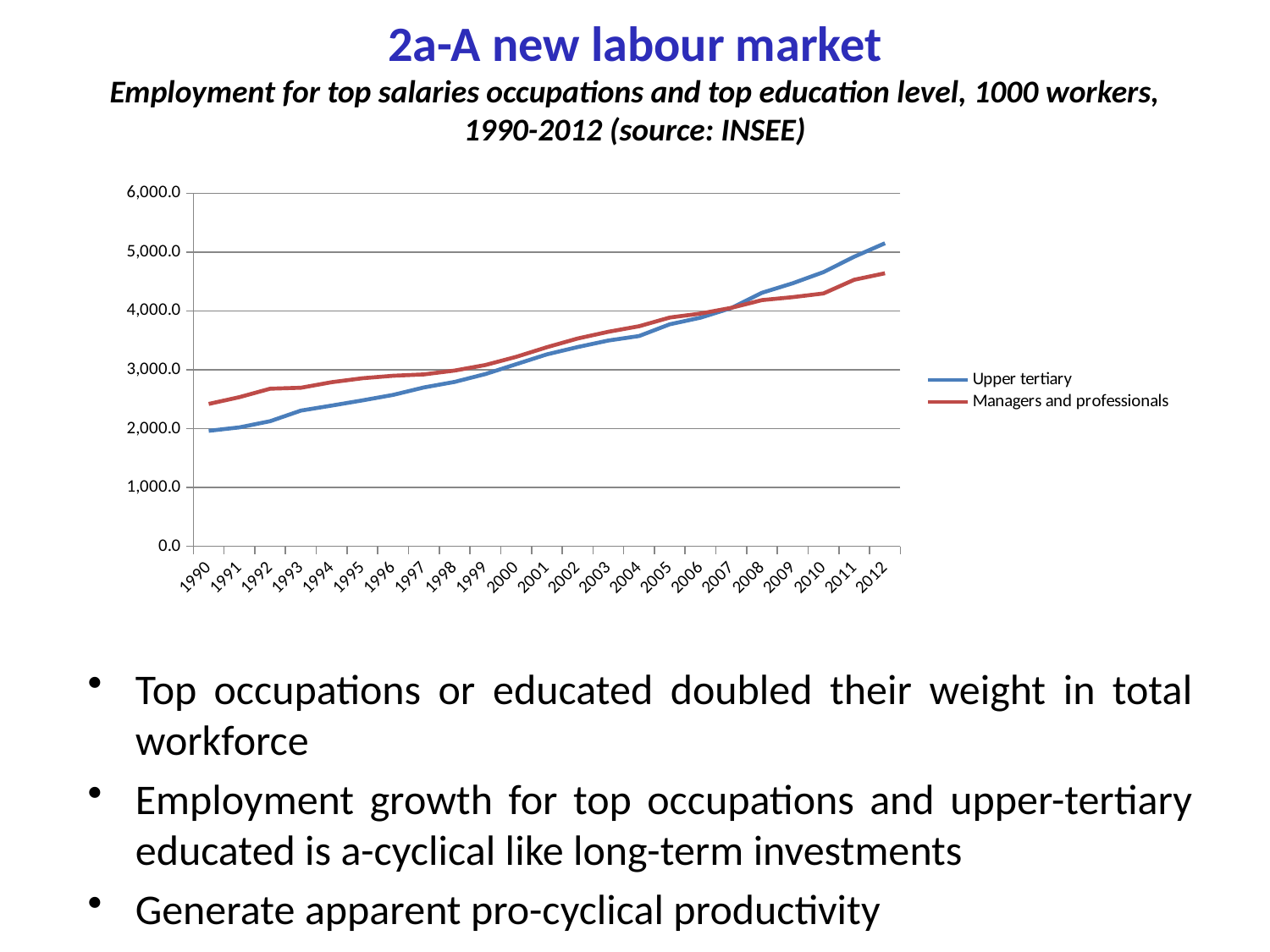
In which year does the Upper tertiary series reach its highest value? 2012 Does the Managers and professionals series rise or fall from 1990 to 2012? rise How many series does the legend list? 2 In 2012, which series has the larger value, Upper tertiary or Managers and professionals? Upper tertiary How many years are plotted along the x axis? 23 Is the value for Upper tertiary in 2012 greater or less than 5,000.0? greater Which two series are listed in the legend? Upper tertiary; Managers and professionals In 1990, which series has the larger value, Upper tertiary or Managers and professionals? Managers and professionals What kind of chart is shown on the slide? line chart Does the Upper tertiary series rise or fall from 1990 to 2012? rise Is the value for Managers and professionals in 1990 greater or less than 2,000.0? greater Is the value for Managers and professionals in 2012 greater or less than 5,000.0? less